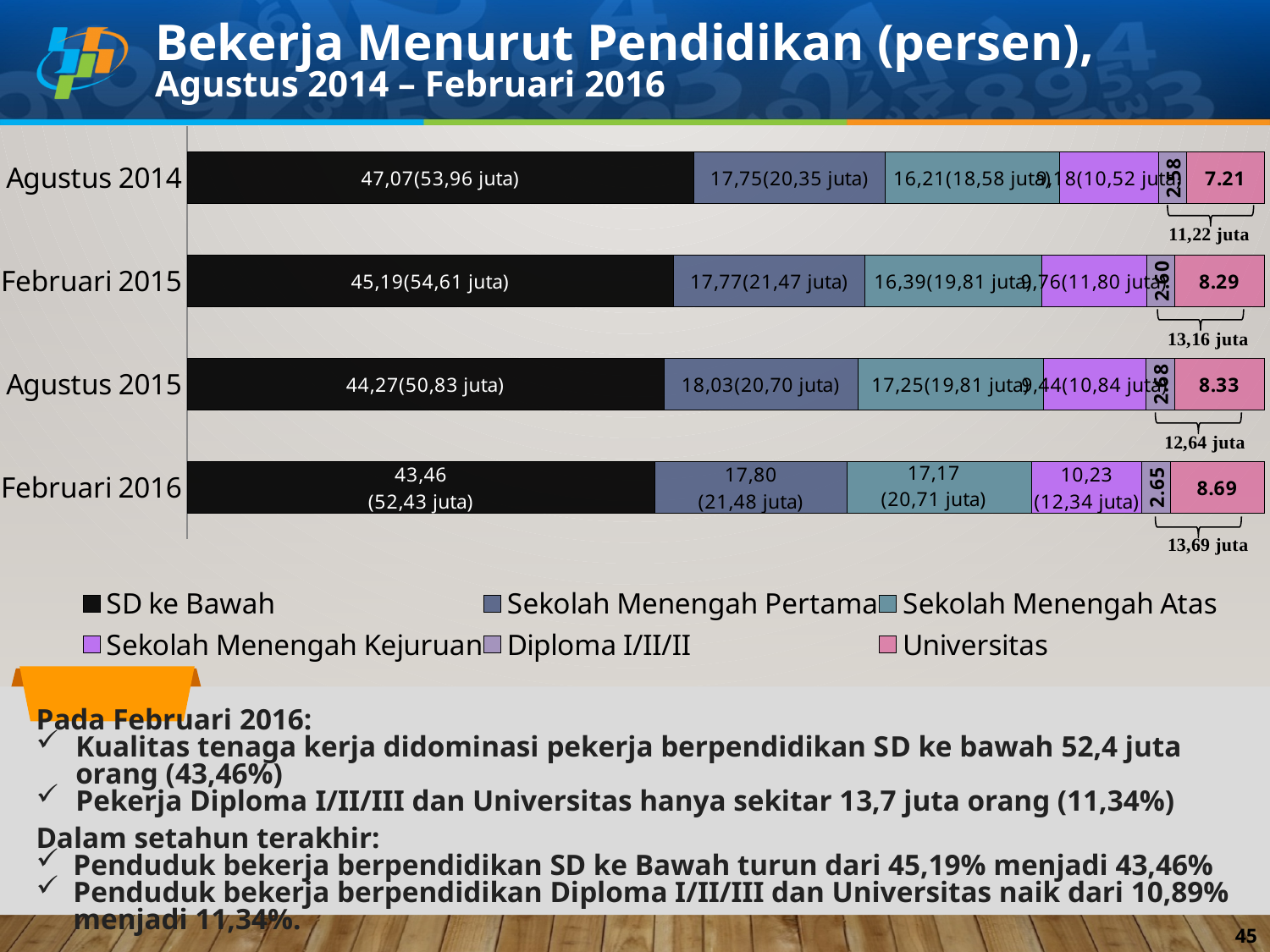
What is the value for SD ke Bawah in Februari 2016? 43,46 (52,43 juta) Which education level has the smallest share of workers in Februari 2016? Diploma I/II/II What is the value for Sekolah Menengah Kejuruan in Februari 2016? 10,23 (12,34 juta) How many time periods (categories) are shown on the chart? 4 What kind of chart is shown on the slide? Stacked bar chart What is the value for Sekolah Menengah Pertama in Agustus 2015? 18,03(20,70 juta) Which education level has the largest share of workers in Agustus 2014? SD ke Bawah Which is larger in Februari 2016: the Sekolah Menengah Pertama percentage or the Sekolah Menengah Atas percentage? Sekolah Menengah Pertama How many series does the legend list? 6 What is the difference in the Universitas percentage between Februari 2016 and Februari 2015? 0.40 What is the value for Universitas in Februari 2015? 8.29 Does the percentage for SD ke Bawah rise or fall from Agustus 2014 to Februari 2016? Fall